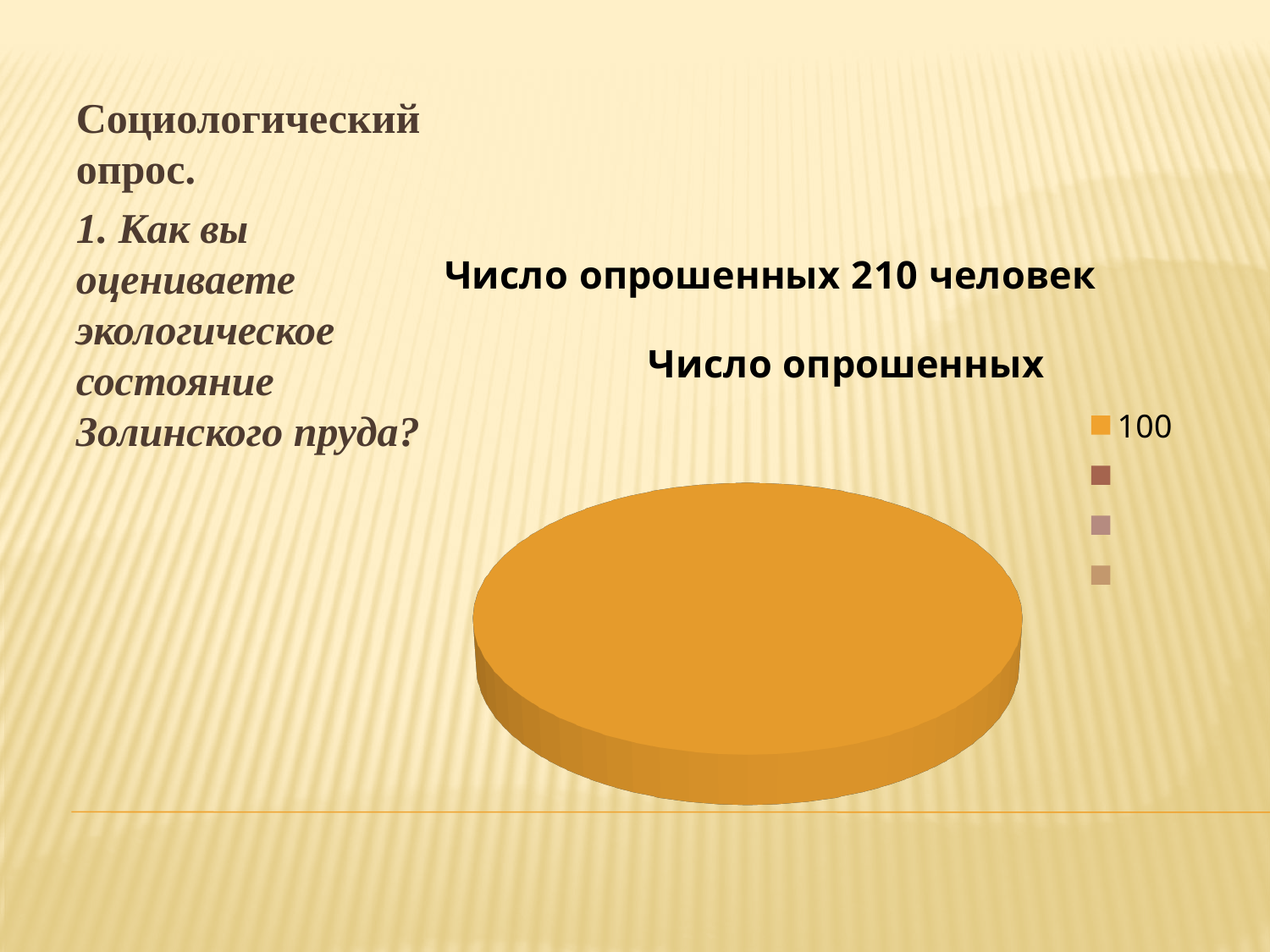
What share of the pie does the orange slice labelled 100 take up? 100% How many colour swatches does the chart's legend show? 4 According to the text above the chart, how many people were surveyed (Число опрошенных)? 210 человек What colour is the slice that fills the pie chart? orange What kind of chart is shown on the slide? pie chart What is the title of the chart? Число опрошенных How many visible slices does the pie chart have? 1 What is the only legend label that is printed next to a swatch in the chart? 100